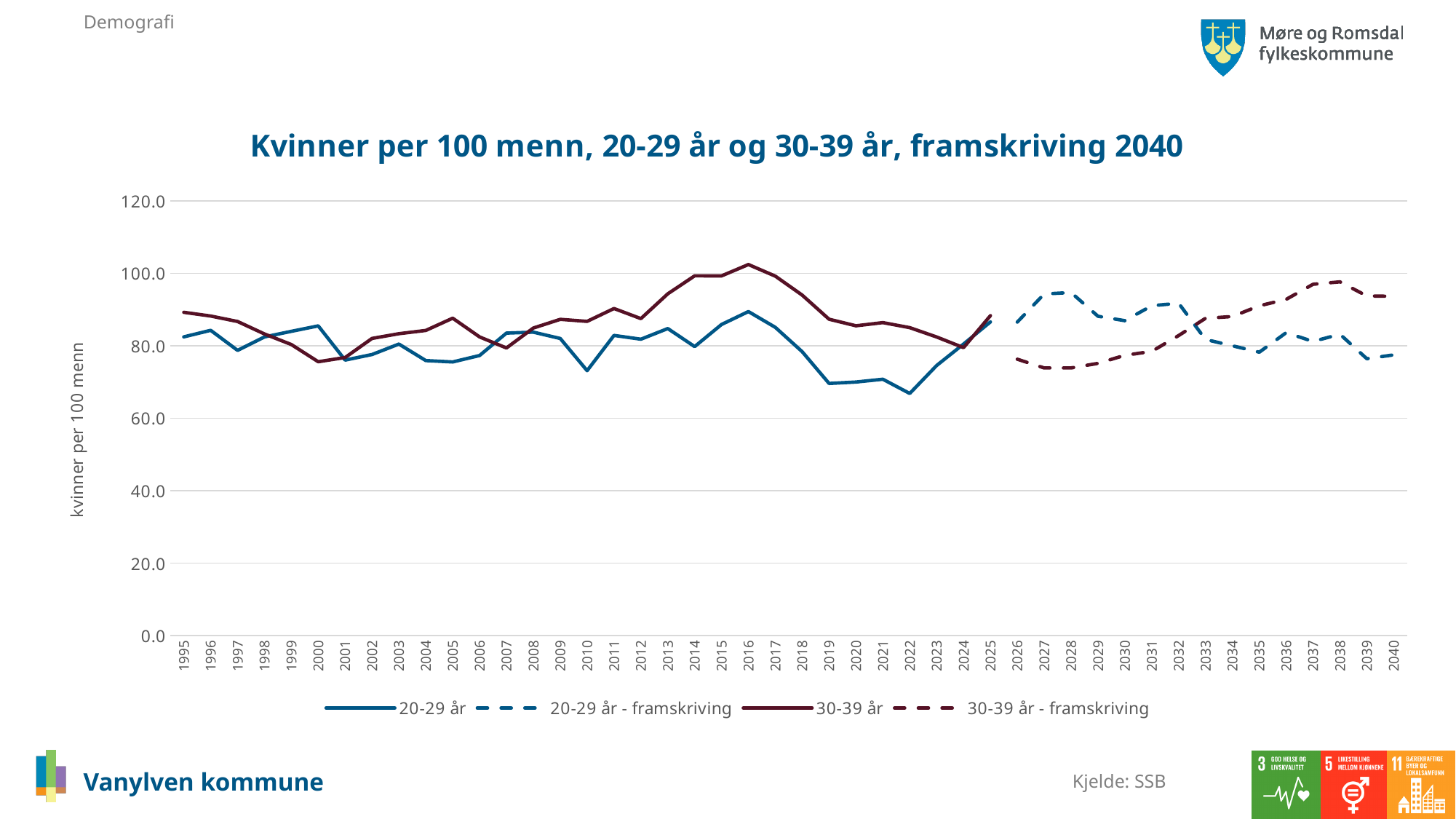
Is the value for 30-39 år in 2016 greater or less than 100? greater In which year does the 30-39 år series reach its highest value? 2016 How many series does the legend list? 4 Is the value for 20-29 år in 2022 greater or less than 80? less Is the value for 30-39 år - framskriving in 2038 greater or less than 100? less How many years are shown on the x axis? 46 Does the 20-29 år series rise or fall between 2016 and 2022? fall What kind of chart is shown on the slide? line chart What is the title of the chart? Kvinner per 100 menn, 20-29 år og 30-39 år, framskriving 2040 What is the label on the vertical axis? kvinner per 100 menn In 2016, which series has the higher value, 20-29 år or 30-39 år? 30-39 år